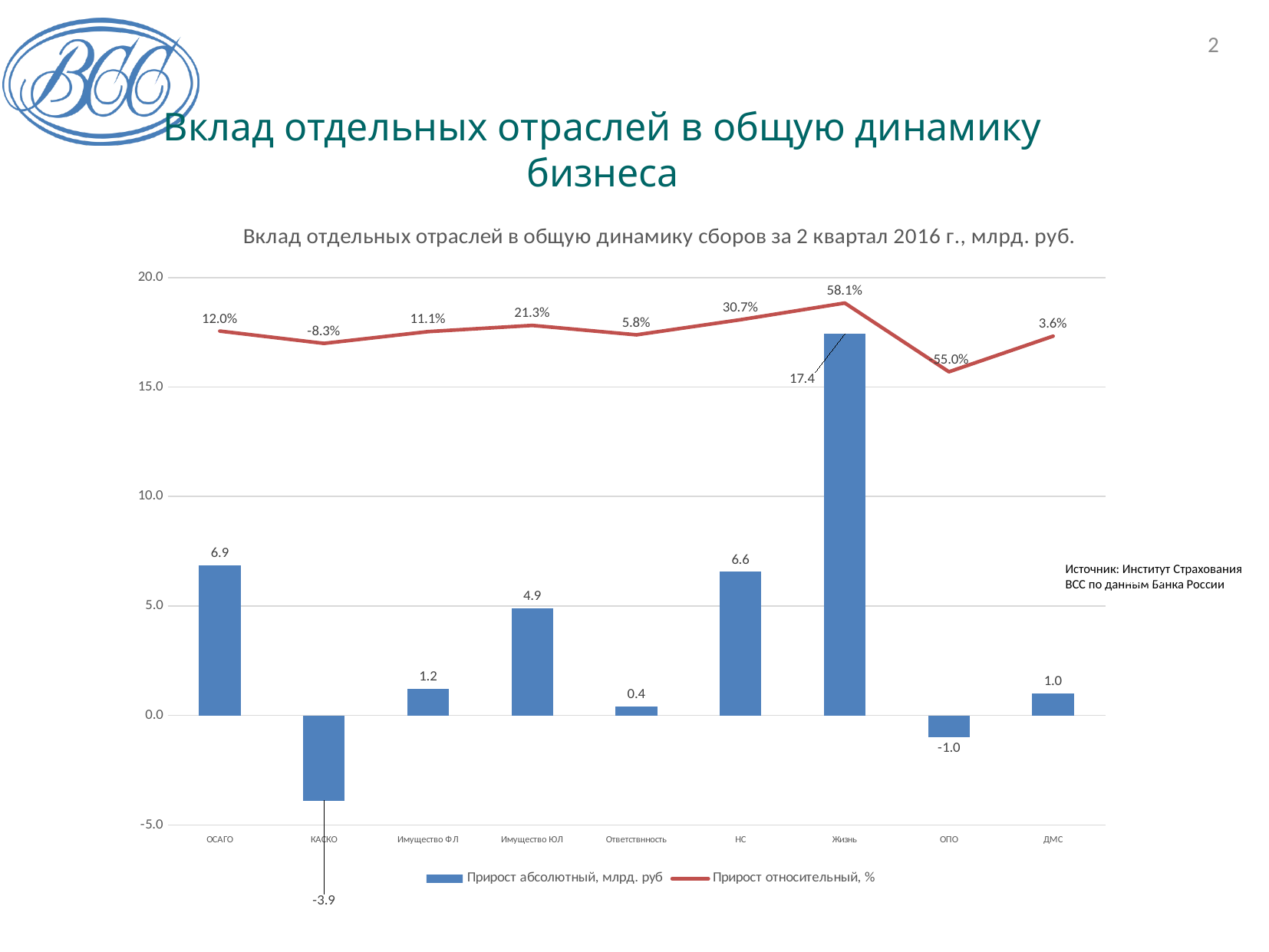
What is the relative growth (Прирост относительный, %) for Имущество ЮЛ? 21.3% What is the absolute growth (Прирост абсолютный, млрд. руб) for Жизнь? 17.4 What is the absolute growth (Прирост абсолютный, млрд. руб) for КАСКО? -3.9 What is the difference between the absolute growth of ОСАГО and НС? 0.3 What is the relative growth (Прирост относительный, %) for НС? 30.7% How many categories are shown on the x axis? 9 Which has a larger absolute growth, Имущество ЮЛ or Имущество ФЛ? Имущество ЮЛ What is the title of the chart? Вклад отдельных отраслей в общую динамику сборов за 2 квартал 2016 г., млрд. руб. What kind of chart is shown on the slide? Combined bar and line chart Which category has the highest absolute growth bar? Жизнь Which category has the lowest absolute growth bar? КАСКО How many series does the legend list? 2